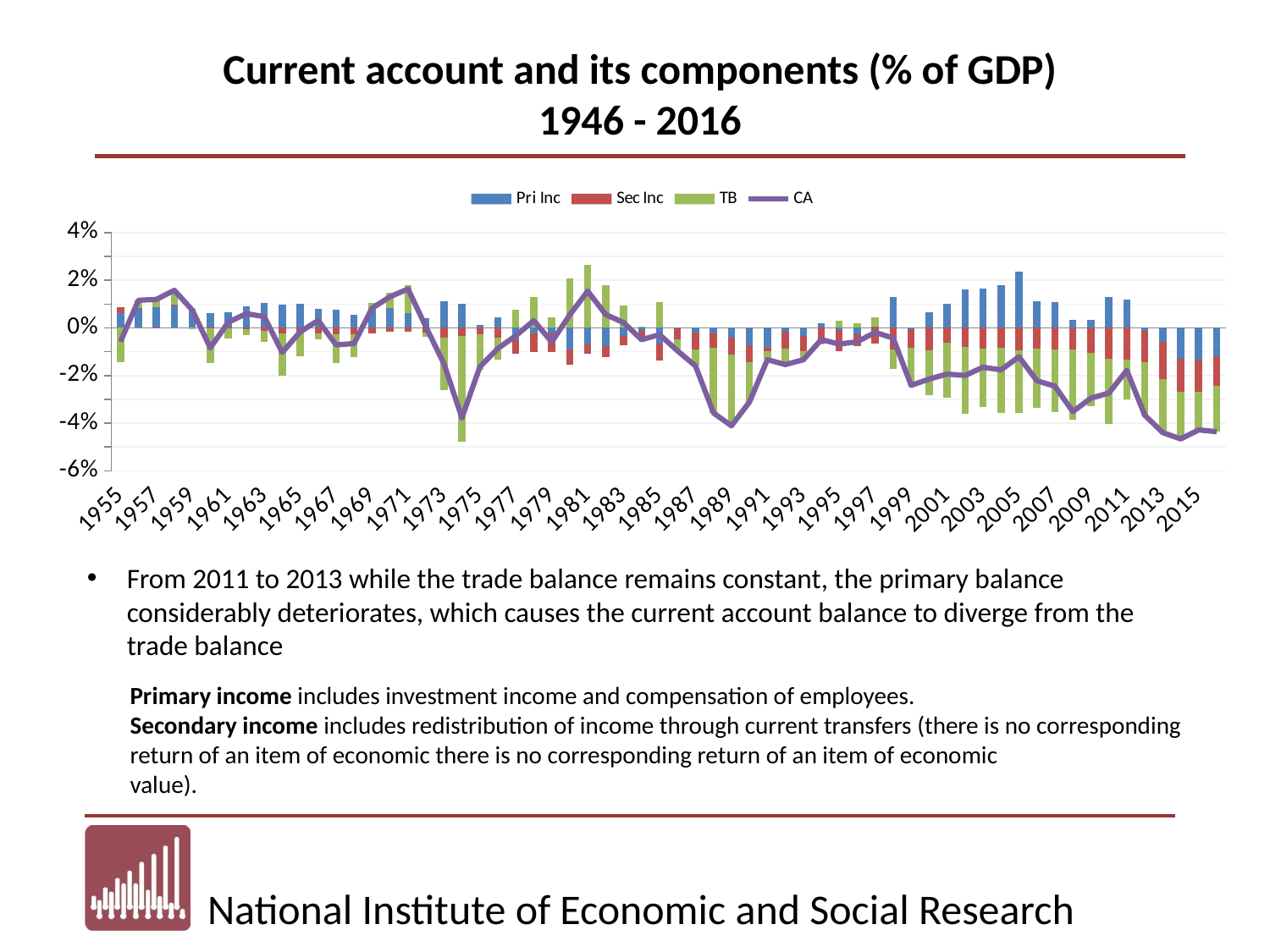
Is the CA value for 1974 greater or less than -2%? less Does the CA line rise or fall from 1955 to 1959? rise What type of chart is shown on the slide? Bar chart (stacked bars with a line) Is the CA value for 1959 greater or less than 0%? greater Is the CA value for 2013 greater or less than -2%? less How many series does the chart legend list? 4 What is the title of the chart? Current account and its components (% of GDP) 1946 - 2016 Which year has the higher CA value, 1971 or 1974? 1971 Which series in the legend is plotted as a line rather than bars? CA Does the CA line rise or fall from 2011 to 2013? fall